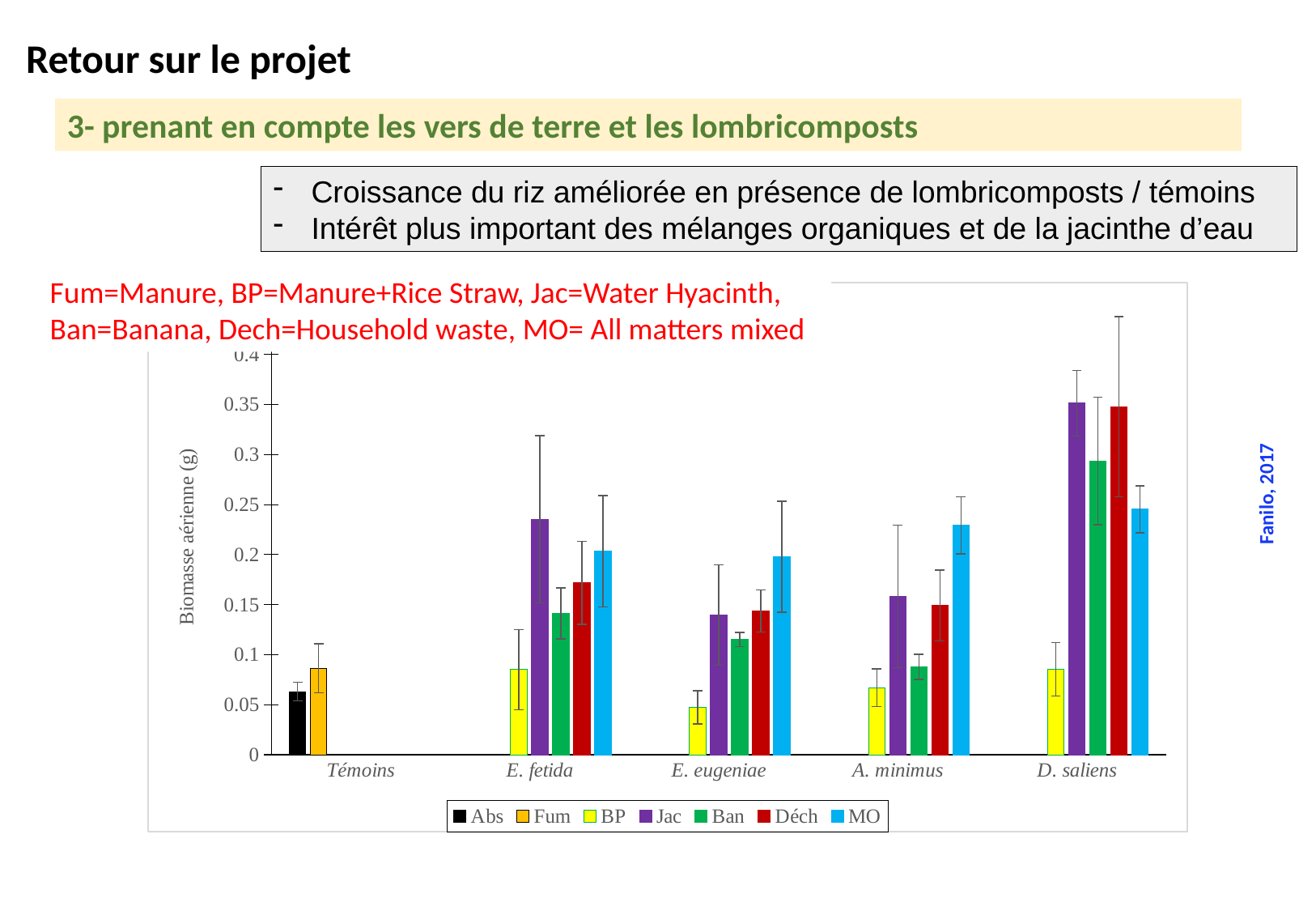
Is the value of the Ban bar for D. saliens greater or less than 0.25? greater What is the label of the vertical axis of the chart? Biomasse aérienne (g) Is the value of the Jac bar for D. saliens greater or less than 0.3? greater Is the value of the Abs bar for Témoins greater or less than 0.1? less For which category is the Jac bar the highest? D. saliens Is the MO bar larger for A. minimus or for E. eugeniae? A. minimus How many categories are shown along the x axis of the chart? 5 Within the E. eugeniae category, which series has the lowest bar? BP Within the A. minimus category, which series has the highest bar? MO What kind of chart is shown on the slide? bar chart How many series does the chart legend list? 7